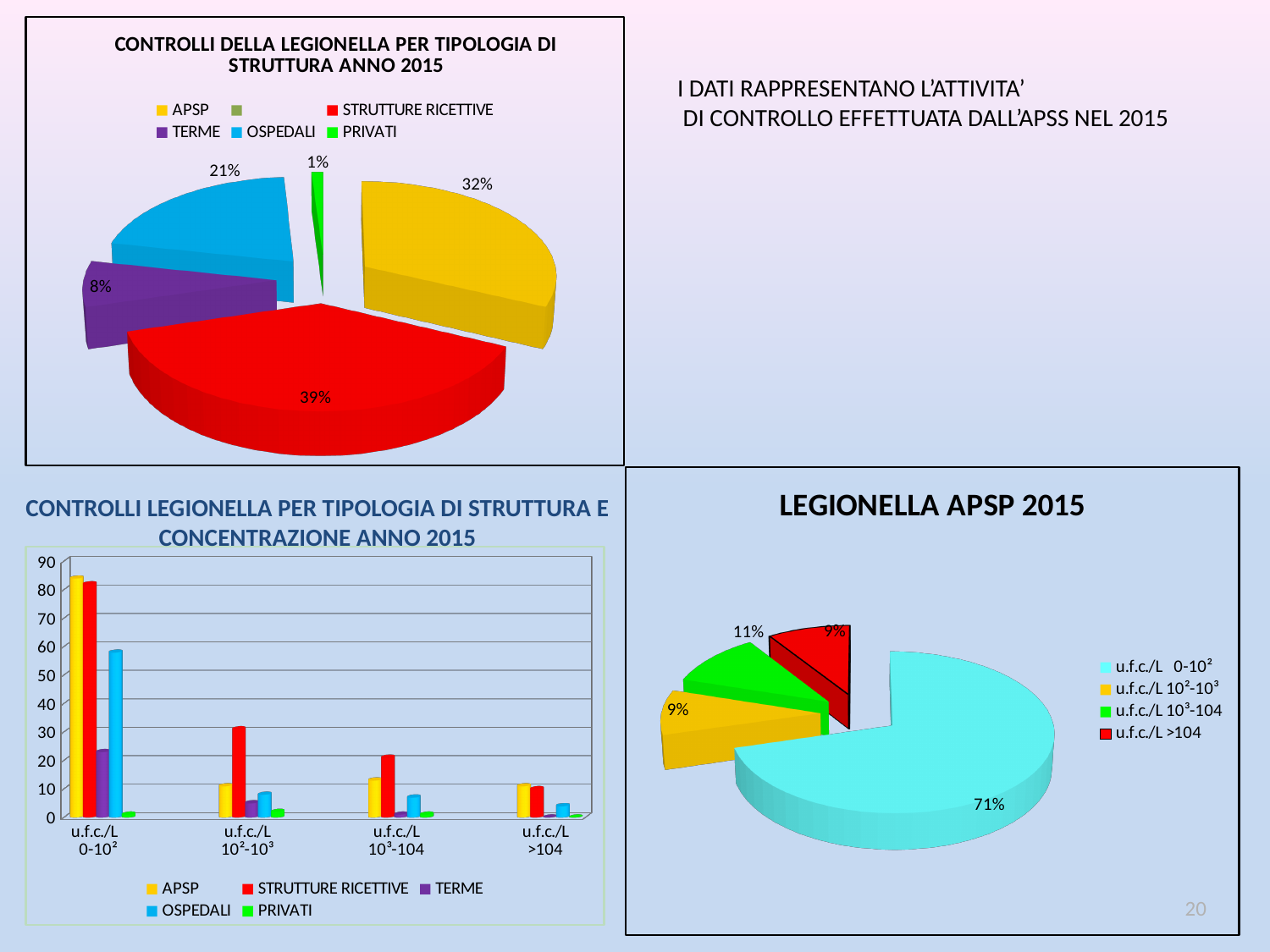
In the chart titled "LEGIONELLA APSP 2015", what share of the pie is u.f.c./L 0-10²? 71% In the chart titled "CONTROLLI DELLA LEGIONELLA PER TIPOLOGIA DI STRUTTURA ANNO 2015", which category has the largest slice? STRUTTURE RICETTIVE In the chart titled "CONTROLLI LEGIONELLA PER TIPOLOGIA DI STRUTTURA E CONCENTRAZIONE ANNO 2015", is the value for OSPEDALI in the u.f.c./L 0-10² category greater or less than 50? greater What kind of chart is the one titled "CONTROLLI LEGIONELLA PER TIPOLOGIA DI STRUTTURA E CONCENTRAZIONE ANNO 2015"? bar chart How many series does the legend list in the chart titled "CONTROLLI LEGIONELLA PER TIPOLOGIA DI STRUTTURA E CONCENTRAZIONE ANNO 2015"? 5 In the chart titled "CONTROLLI LEGIONELLA PER TIPOLOGIA DI STRUTTURA E CONCENTRAZIONE ANNO 2015", how many categories are shown on the x axis? 4 In the chart titled "CONTROLLI DELLA LEGIONELLA PER TIPOLOGIA DI STRUTTURA ANNO 2015", what share of the pie is STRUTTURE RICETTIVE? 39% In the chart titled "CONTROLLI DELLA LEGIONELLA PER TIPOLOGIA DI STRUTTURA ANNO 2015", which category has the smallest slice? PRIVATI In the chart titled "CONTROLLI LEGIONELLA PER TIPOLOGIA DI STRUTTURA E CONCENTRAZIONE ANNO 2015", is the value for STRUTTURE RICETTIVE in the u.f.c./L 10²-10³ category greater or less than 20? greater In the chart titled "CONTROLLI DELLA LEGIONELLA PER TIPOLOGIA DI STRUTTURA ANNO 2015", what is the difference in percentage points between APSP and TERME? 24 In the chart titled "LEGIONELLA APSP 2015", which is larger, the u.f.c./L 10³-104 slice or the u.f.c./L >104 slice? u.f.c./L 10³-104 In the chart titled "CONTROLLI DELLA LEGIONELLA PER TIPOLOGIA DI STRUTTURA ANNO 2015", what share of the pie is OSPEDALI? 21%